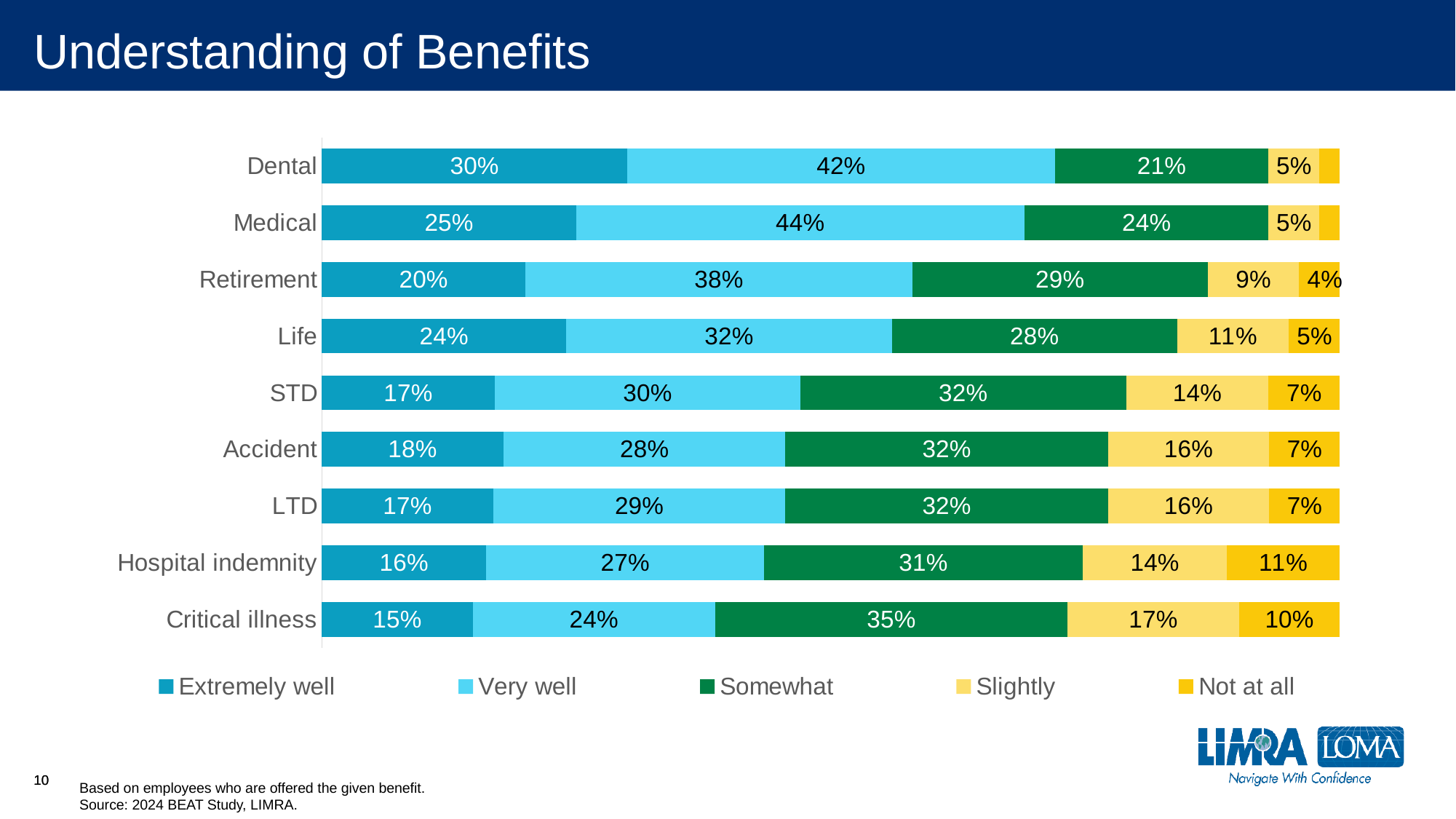
What is the "Extremely well" value for Critical illness? 15% What is the "Not at all" value for Hospital indemnity? 11% What percentage of employees understand their Dental benefits "Very well"? 42% Which has a larger "Somewhat" value, STD or Retirement? STD What is the difference between the "Very well" values for Medical and Life? 12 percentage points What is the "Somewhat" value for Retirement? 29% Which benefit has the lowest "Extremely well" percentage? Critical illness How many benefit categories are shown in the chart? 9 How many series does the legend list? 5 What kind of chart is shown on the slide? Stacked bar chart Which benefit has the highest "Extremely well" percentage? Dental What is the total of the labeled segments in the Retirement bar? 100%